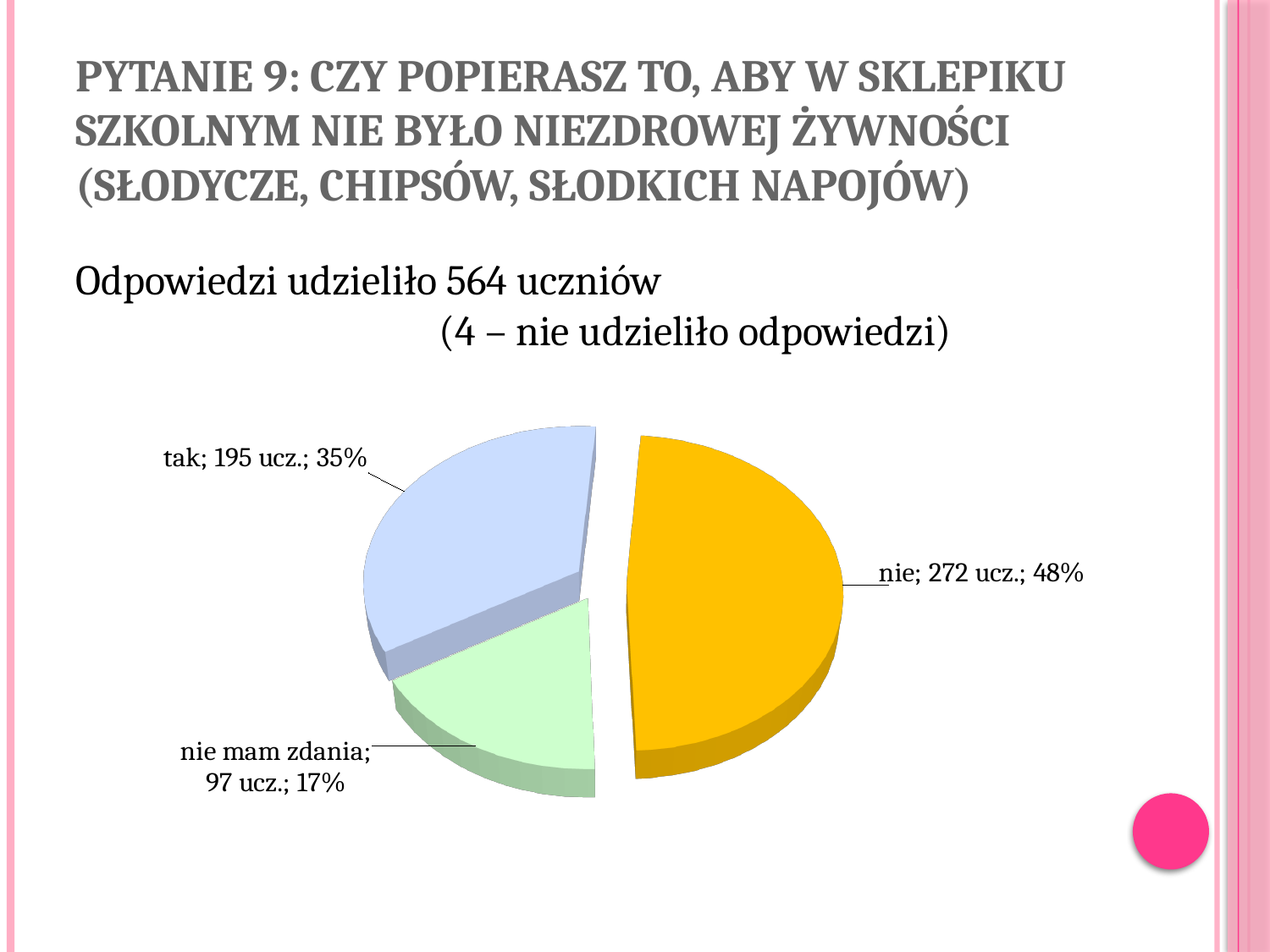
What percentage of the pie does the "tak" slice represent? 35% What is the total number of students across all three slices? 564 Which answer has the largest slice of the pie? nie How many students answered "nie"? 272 ucz. What percentage of the pie does the "nie" slice represent? 48% Which answer has the smallest slice of the pie? nie mam zdania What is the difference in the number of students between "nie" and "tak"? 77 ucz. Which answer was given by more students, "tak" or "nie mam zdania"? tak What colour is the "nie" slice? orange/yellow How many students answered "nie mam zdania"? 97 ucz. How many slices does the pie chart have? 3 What kind of chart is shown on the slide? pie chart